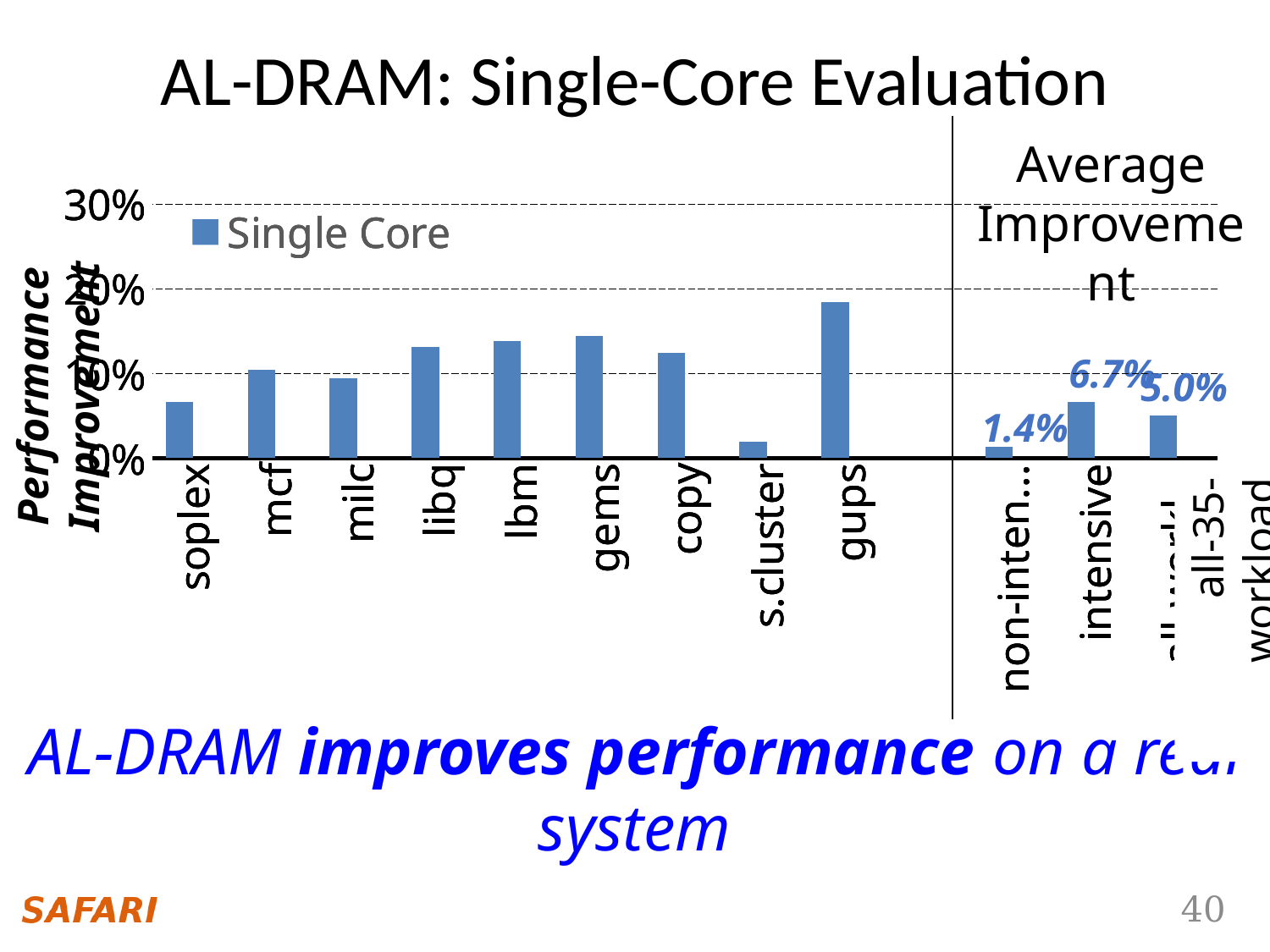
What kind of chart is shown on the slide? bar chart How many series does the legend list? 1 What is the legend entry for the plotted series? Single Core Which has a larger performance improvement, lbm or s.cluster? lbm What is the average performance improvement for the intensive workloads? 6.7% Is the performance improvement for gups greater or less than 10%? greater What is the difference between the average improvement for intensive and non-intensive workloads? 5.3% Is the performance improvement for soplex greater or less than 10%? less Which benchmark has the highest single-core performance improvement? gups Which has a larger performance improvement, gups or soplex? gups What is the average performance improvement for the non-intensive workloads? 1.4% What is the average performance improvement across all 35 workloads? 5.0%